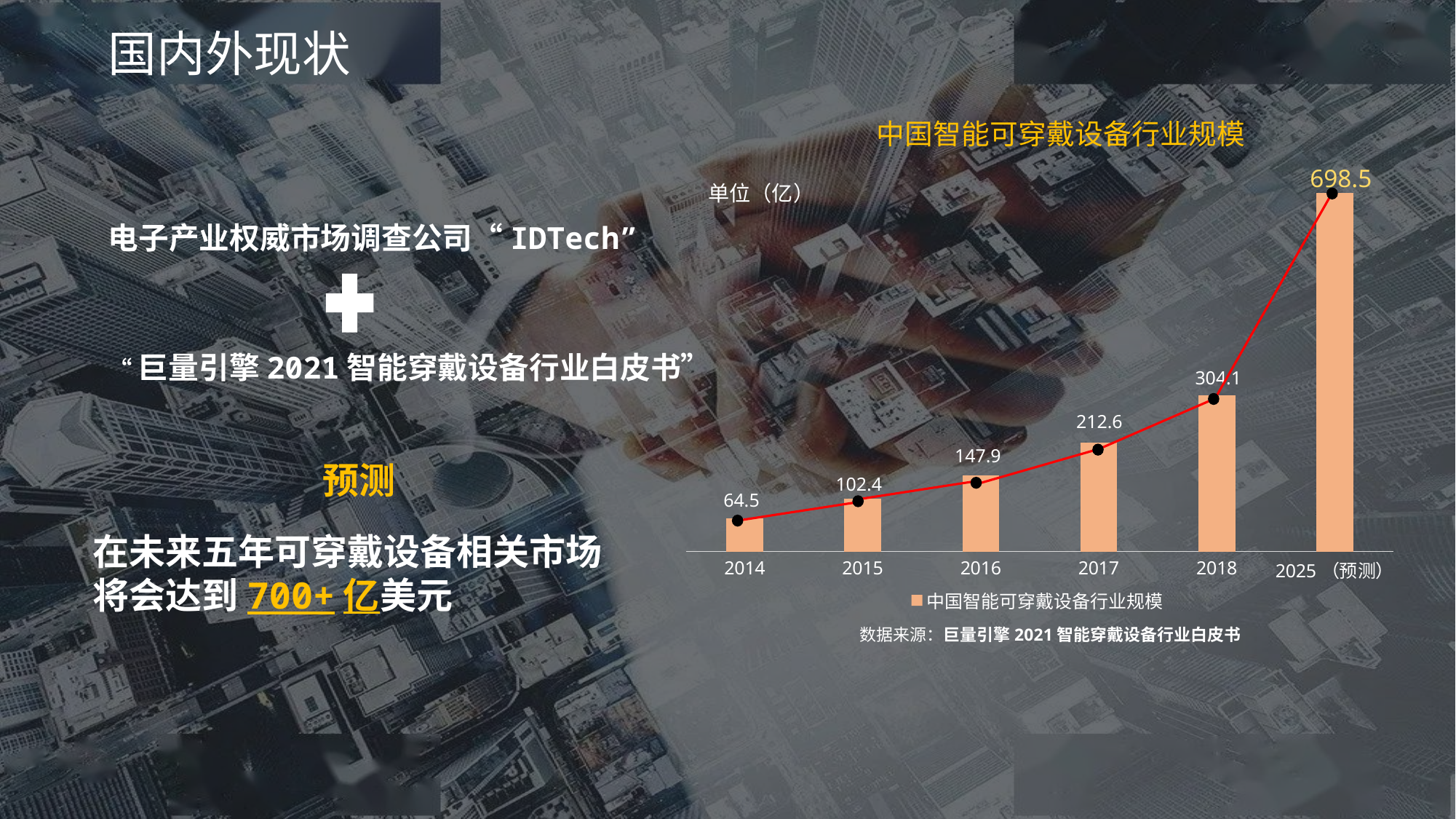
What unit is stated for the values in the 中国智能可穿戴设备行业规模 chart? 亿 Which year has the highest value in the 中国智能可穿戴设备行业规模 chart? 2025（预测） What is the difference between the 2018 and 2017 values in the 中国智能可穿戴设备行业规模 chart? 91.5 What is the value for 2018 in the 中国智能可穿戴设备行业规模 chart? 304.1 What is the difference between the 2015 and 2014 values in the 中国智能可穿戴设备行业规模 chart? 37.9 Do the values in the 中国智能可穿戴设备行业规模 chart rise or fall from 2014 to 2025? rise What is the value for 2016 in the 中国智能可穿戴设备行业规模 chart? 147.9 Which year has the lowest value in the 中国智能可穿戴设备行业规模 chart? 2014 What is the forecast value for 2025 (预测) in the 中国智能可穿戴设备行业规模 chart? 698.5 What is the value for 2014 in the 中国智能可穿戴设备行业规模 chart? 64.5 Which is larger in the 中国智能可穿戴设备行业规模 chart, the value for 2017 or the value for 2016? 2017 How many years (categories) are shown on the x axis of the 中国智能可穿戴设备行业规模 chart? 6